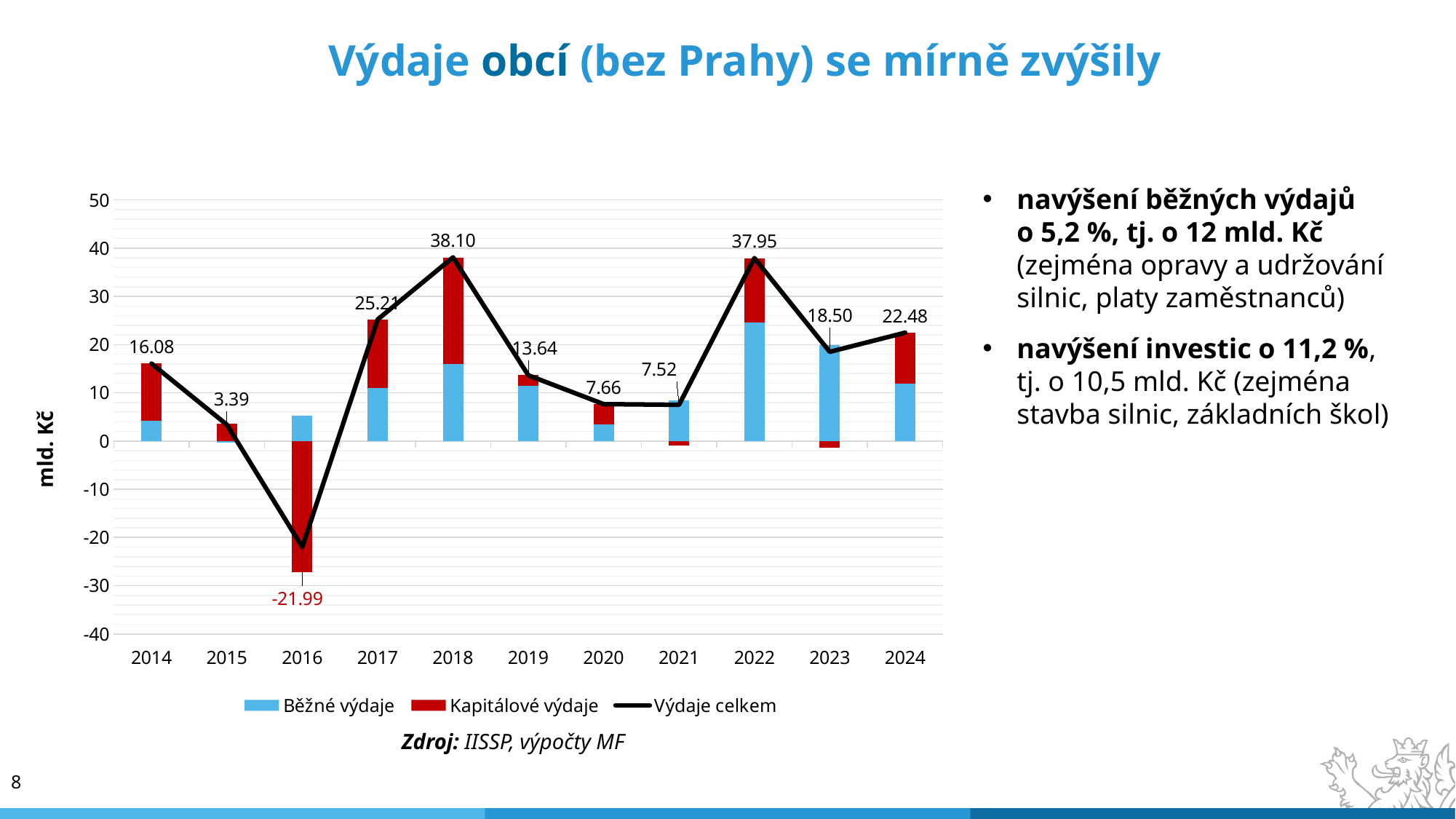
Is the value of Běžné výdaje for 2022 greater or less than 20? greater How many years are shown on the x axis? 11 In which year is Výdaje celkem lowest? 2016 What is the value of Výdaje celkem for 2016? -21.99 What is the label of the vertical axis? mld. Kč What is the value of Výdaje celkem for 2018? 38.10 Which year has the larger Výdaje celkem, 2022 or 2023? 2022 How many series does the legend list? 3 What is the difference between Výdaje celkem in 2018 and 2017? 12.89 In which year is Výdaje celkem highest? 2018 What is the value of Výdaje celkem for 2024? 22.48 What kind of chart is shown on the slide? Combined stacked bar and line chart